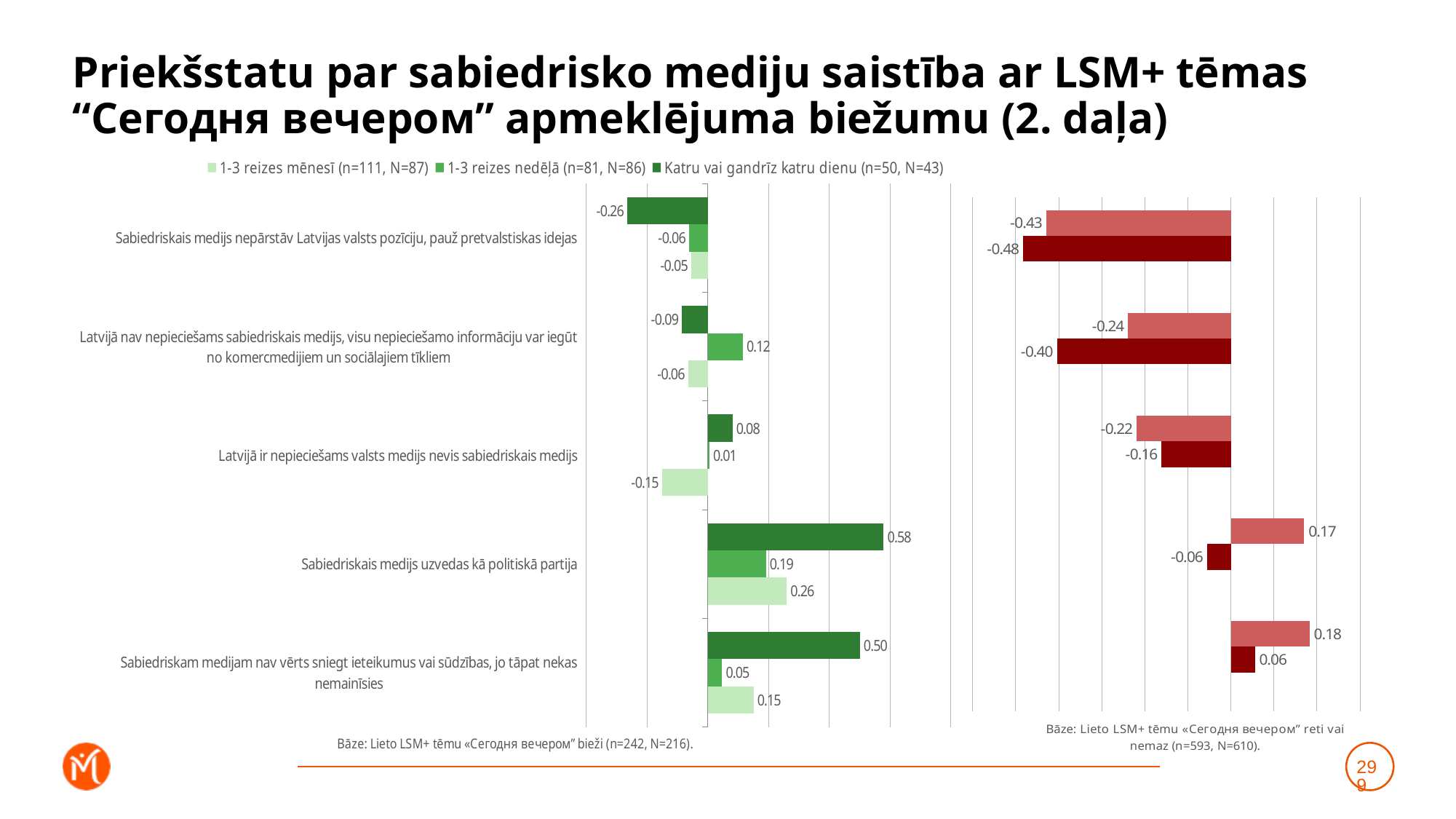
In the right (red) chart, what is the value of the dark red bar for 'Sabiedriskais medijs nepārstāv Latvijas valsts pozīciju, pauž pretvalstiskas idejas'? -0.48 In the left (green) chart, what is the value for '1-3 reizes mēnesī' for 'Latvijā ir nepieciešams valsts medijs nevis sabiedriskais medijs'? -0.15 In the left (green) chart, which category has the highest value for 'Katru vai gandrīz katru dienu'? Sabiedriskais medijs uzvedas kā politiskā partija How many series does the legend of the left (green) chart list? 3 In the left (green) chart, what is the value for 'Katru vai gandrīz katru dienu' for 'Sabiedriskais medijs uzvedas kā politiskā partija'? 0.58 In the left (green) chart, which category has the lowest value for 'Katru vai gandrīz katru dienu'? Sabiedriskais medijs nepārstāv Latvijas valsts pozīciju, pauž pretvalstiskas idejas In the left (green) chart, what is the difference between the 'Katru vai gandrīz katru dienu' value (0.50) and the '1-3 reizes mēnesī' value (0.15) for 'Sabiedriskam medijam nav vērts sniegt ieteikumus vai sūdzības, jo tāpat nekas nemainīsies'? 0.35 In the left (green) chart, for 'Sabiedriskais medijs uzvedas kā politiskā partija', which is larger: the '1-3 reizes nedēļā' value or the '1-3 reizes mēnesī' value? 1-3 reizes mēnesī In the left (green) chart, what is the value for '1-3 reizes nedēļā' for 'Latvijā nav nepieciešams sabiedriskais medijs, visu nepieciešamo informāciju var iegūt no komercmedijiem un sociālajiem tīkliem'? 0.12 How many categories are shown in the left (green) chart? 5 In the right (red) chart, what is the value of the lighter red bar for 'Sabiedriskam medijam nav vērts sniegt ieteikumus vai sūdzības, jo tāpat nekas nemainīsies'? 0.18 What kind of chart is the left (green) chart? Bar chart